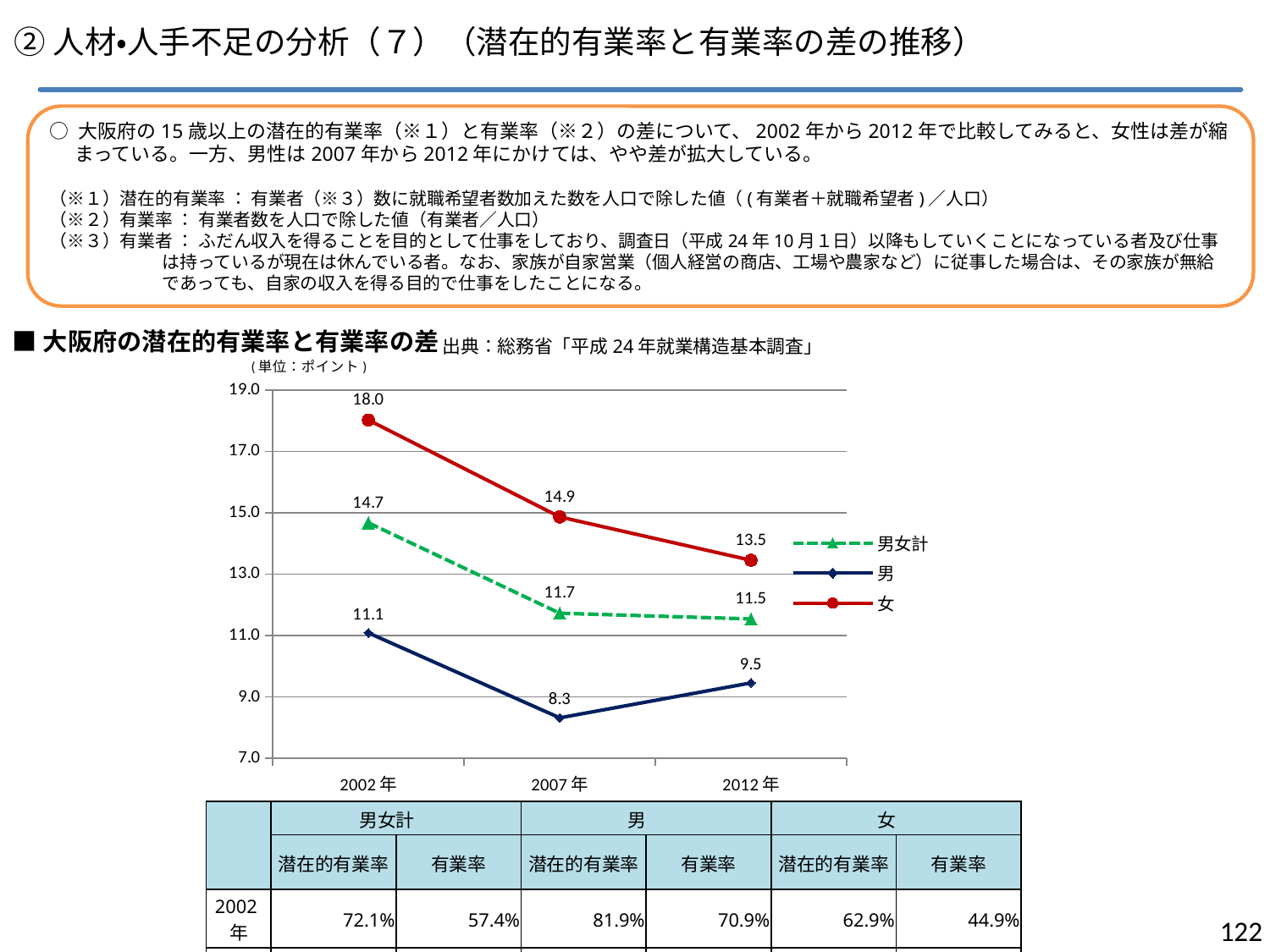
What is the value for 男女計 in 2012年? 11.5 Which year has the lowest value for the 男 series? 2007年 What is the value for 女 in 2002年? 18.0 Which is larger in 2007年, the value for 男女計 or the value for 男? 男女計 How many series does the chart legend list? 3 How many years are plotted on the x axis? 3 What is the value for 男 in 2007年? 8.3 What type of chart is shown on the slide? line chart What is the difference between the 女 value and the 男 value in 2012年? 4.0 Does the 男 series rise or fall from 2007年 to 2012年? rise Which year has the highest value for the 女 series? 2002年 Which series is drawn with a dashed line? 男女計